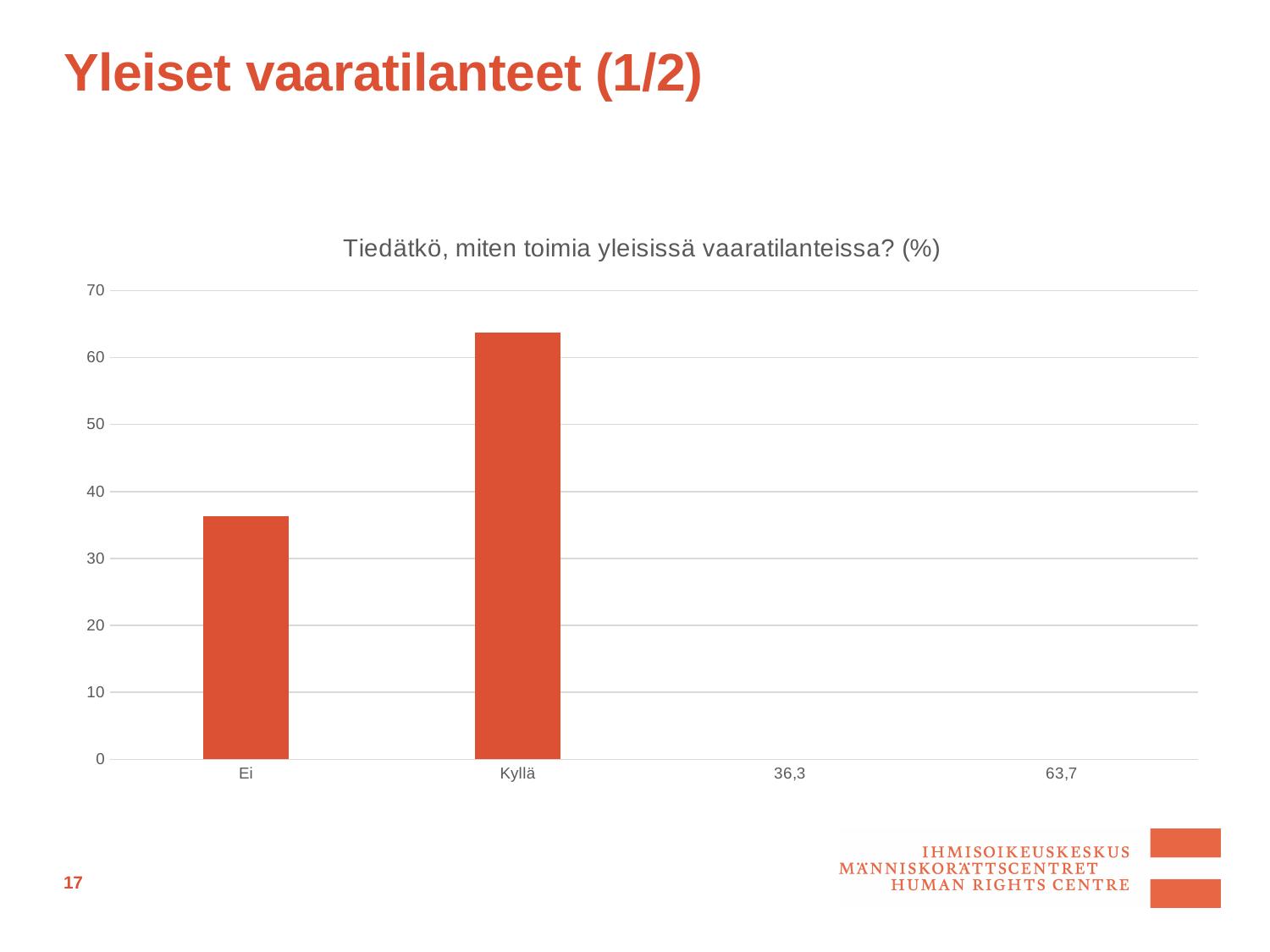
What is the title of the chart? Tiedätkö, miten toimia yleisissä vaaratilanteissa? (%) Which category has the highest bar? Kyllä What is the highest value shown on the vertical axis? 70 Which is larger, the value for Ei or the value for Kyllä? Kyllä Is the value for Ei greater or less than 40? less How many bars are plotted in the chart? 2 Is the value for Kyllä greater or less than 60? greater What kind of chart is shown on the slide? bar chart Is the value for Kyllä greater or less than 70? less Which category has the lowest bar? Ei